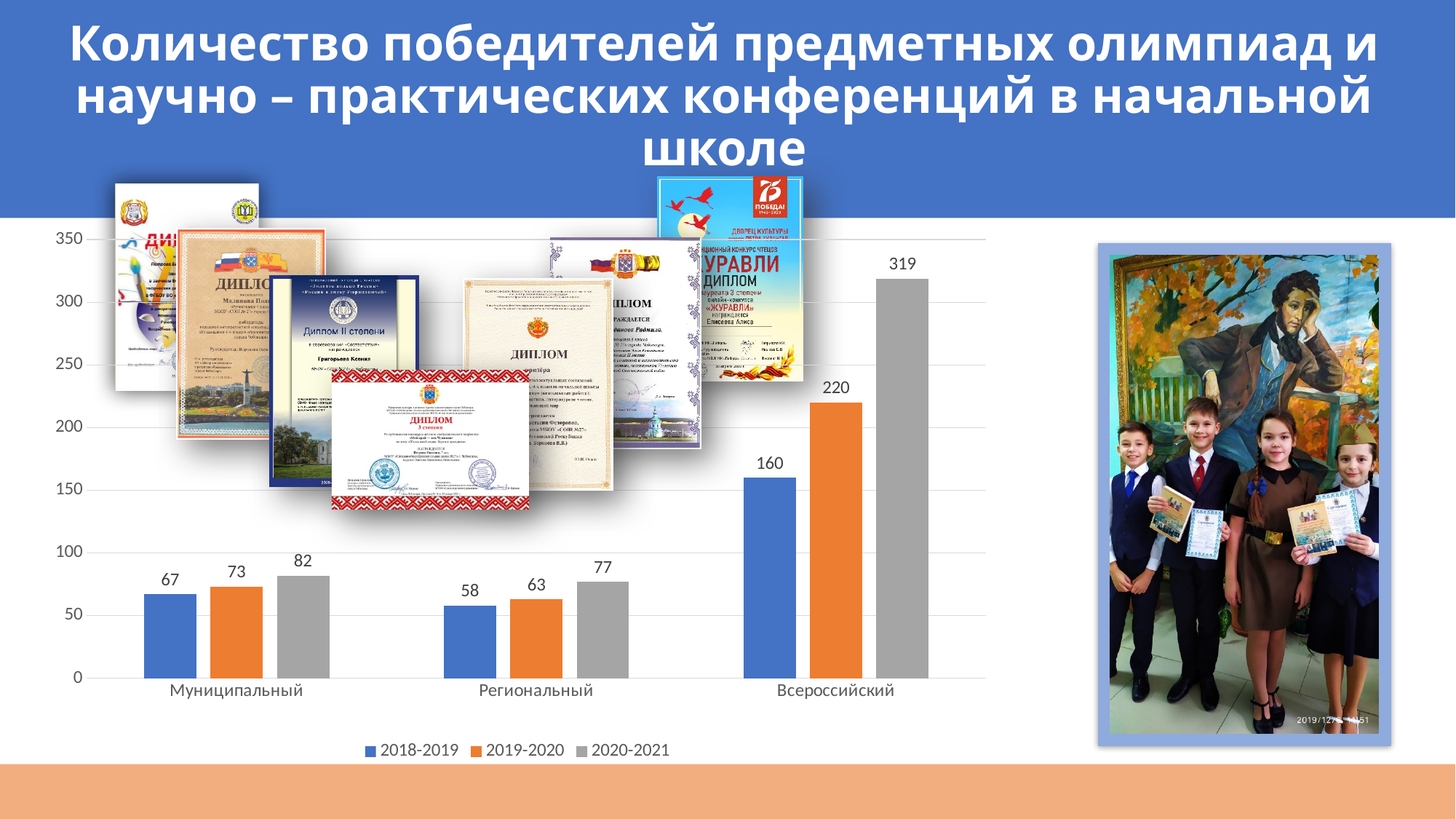
How many categories are shown on the x axis? 3 Do the values for Всероссийский rise or fall from 2018-2019 to 2020-2021? rise What is the value for Всероссийский in the 2020-2021 series? 319 Which category has the lowest value in the 2018-2019 series? Региональный What kind of chart is shown on the slide? bar chart What is the value for Региональный in the 2019-2020 series? 63 What is the difference between the 2020-2021 values for Муниципальный and Региональный? 5 Which category has the highest value in the 2019-2020 series? Всероссийский Which is larger: the 2019-2020 value for Муниципальный or the 2019-2020 value for Региональный? Муниципальный What is the value for Муниципальный in the 2018-2019 series? 67 How many series does the legend list? 3 What is the difference between the 2020-2021 and 2018-2019 values for Всероссийский? 159